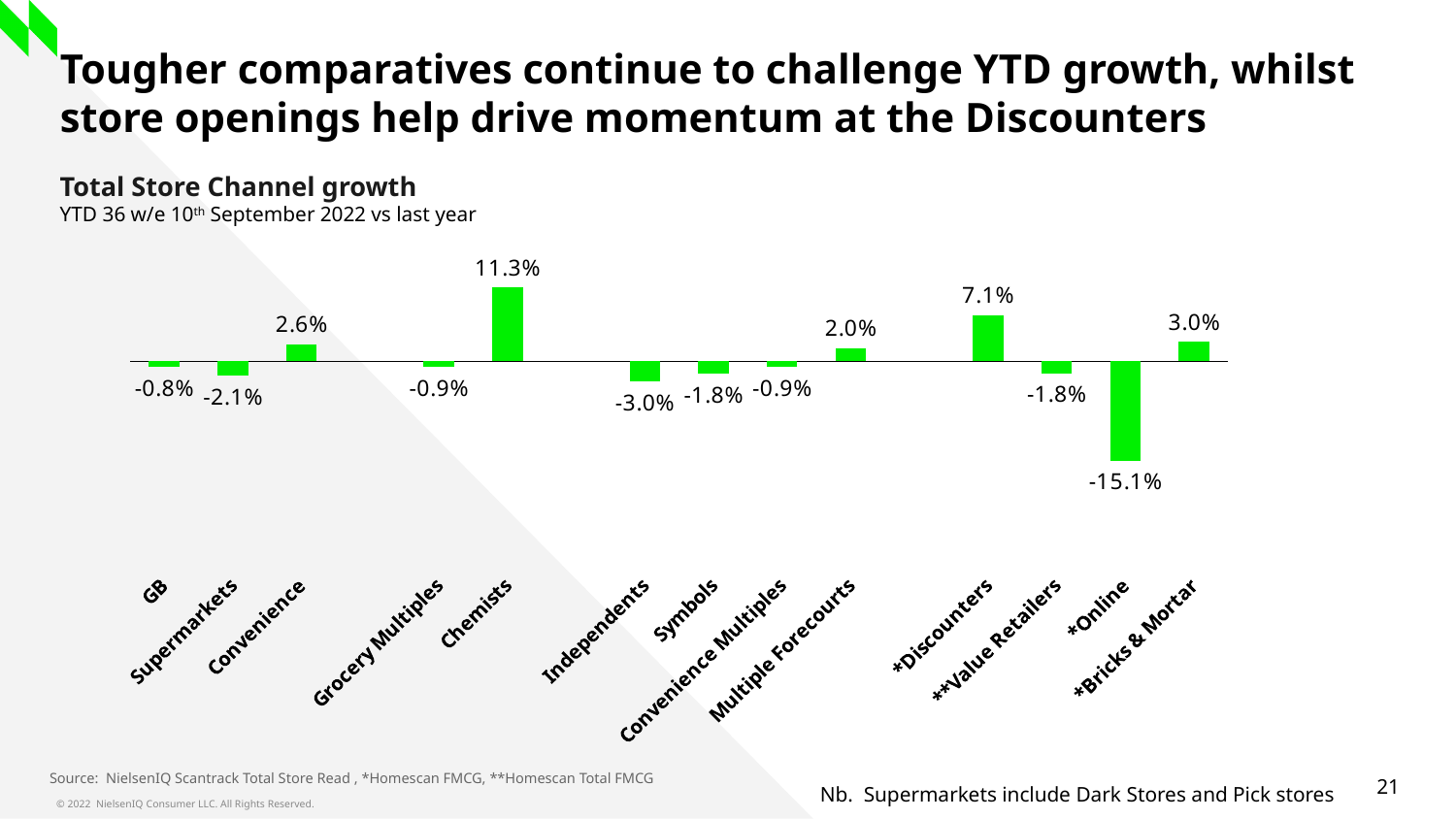
What is the title of the chart? Total Store Channel growth Which channel has the highest growth value? Chemists What is the growth value shown for *Online? -15.1% What is the growth value shown for Chemists? 11.3% What is the growth value shown for Independents? -3.0% How many channel categories are plotted on the chart? 13 What type of chart is used on this slide? Bar chart Which has the larger growth value, Convenience or Multiple Forecourts? Convenience What is the growth value shown for Supermarkets? -2.1% What is the difference in percentage points between the Chemists value and the *Discounters value? 4.2 percentage points Which channel has the lowest growth value? *Online What is the growth value shown for *Discounters? 7.1%